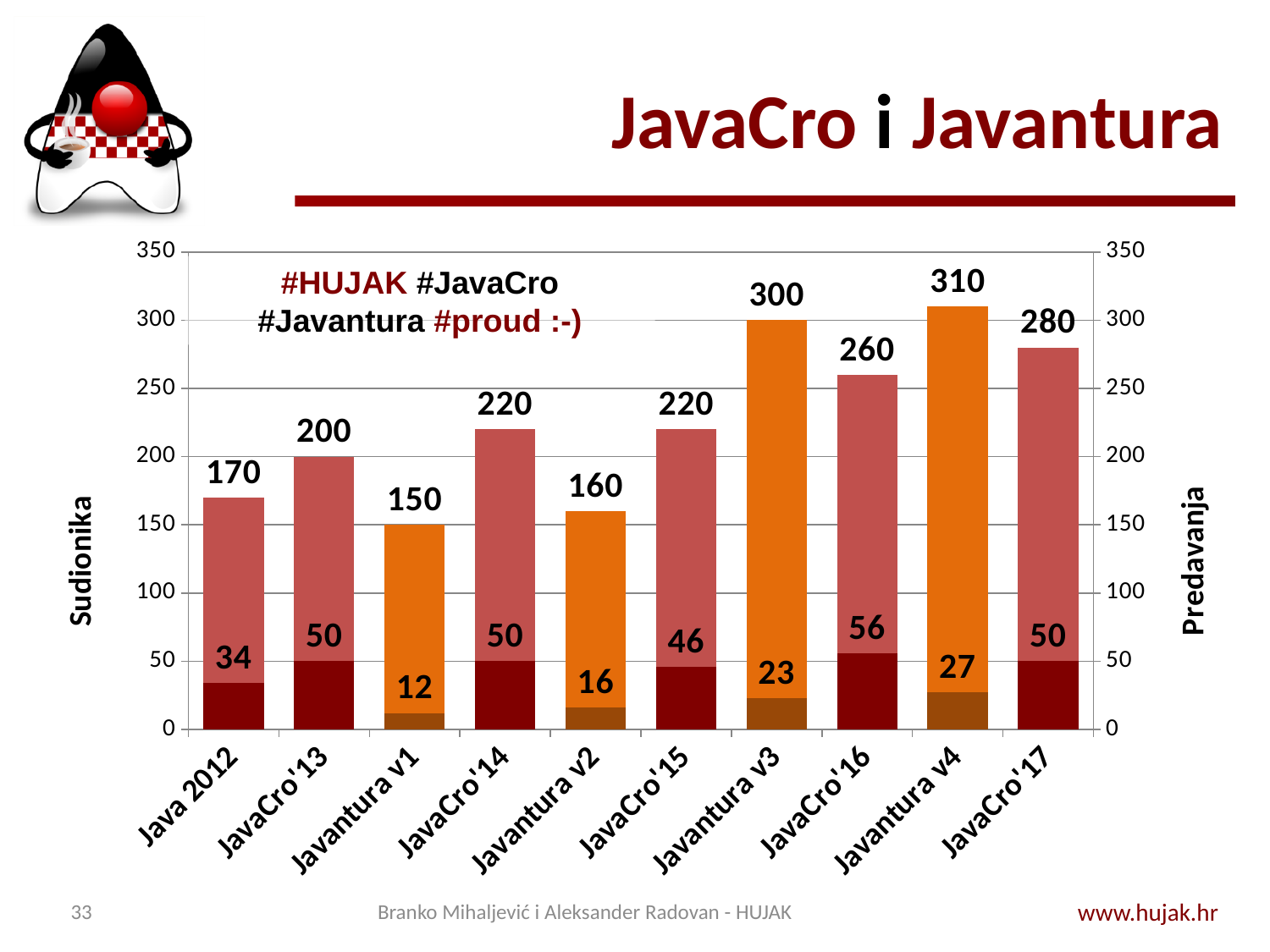
Which event has the highest number of lectures (Predavanja)? JavaCro'16 What is the difference in lectures (Predavanja) between JavaCro'16 and Javantura v2? 40 How many events (categories) are shown on the x axis? 10 What is the number of participants (Sudionika) for JavaCro'14? 220 What is the label of the left vertical axis? Sudionika What is the number of lectures (Predavanja) for Javantura v3? 23 What kind of chart is shown on the slide? bar chart Which event has the lowest number of lectures (Predavanja)? Javantura v1 What is the difference in participants (Sudionika) between Javantura v4 and Javantura v1? 160 Which has more participants (Sudionika), JavaCro'16 or JavaCro'17? JavaCro'17 What is the number of participants (Sudionika) for Java 2012? 170 Which event has the highest number of participants (Sudionika)? Javantura v4